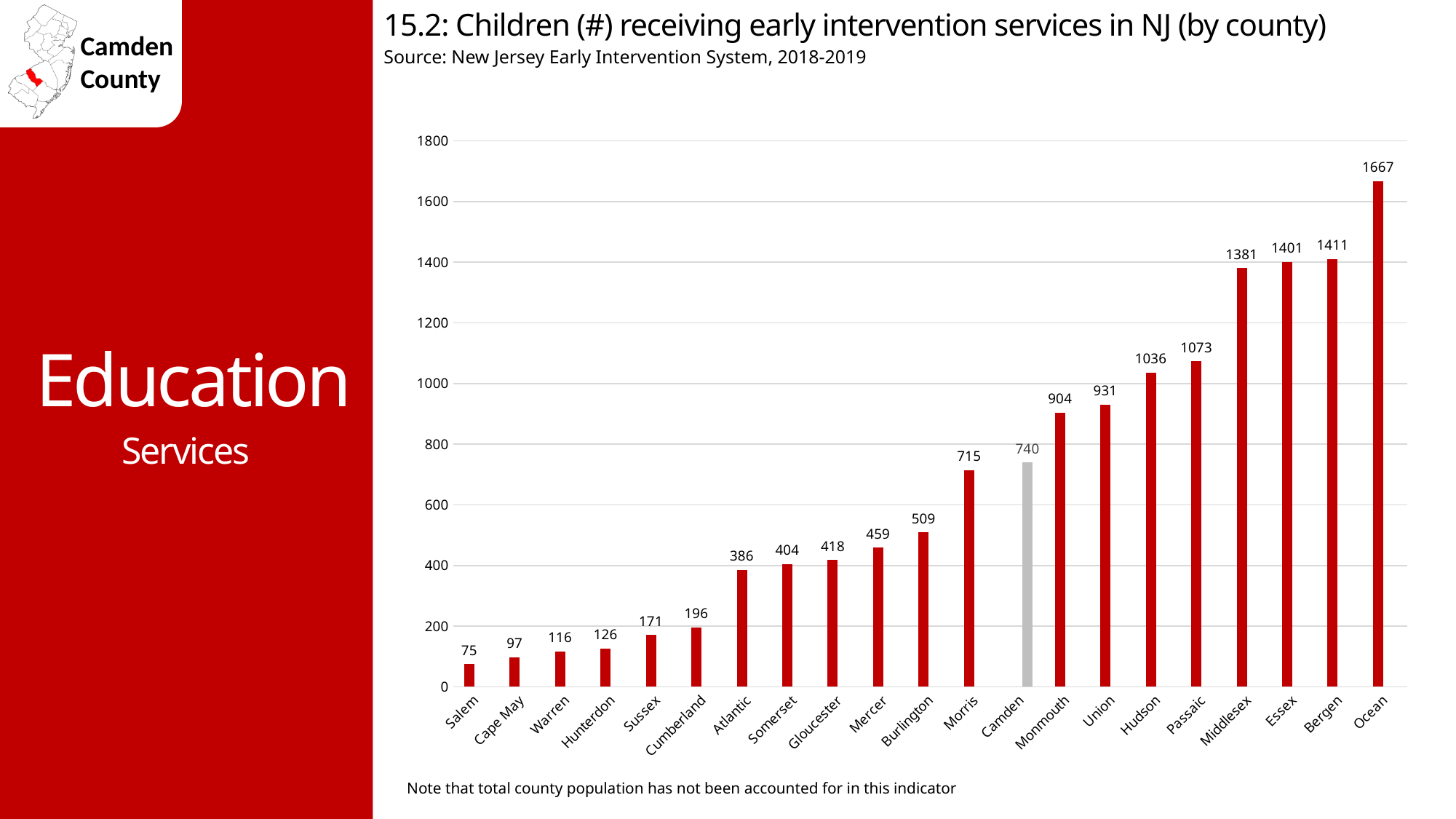
What is the difference between the values for Bergen and Essex? 10 How many children received early intervention services in Camden County? 740 What is the value shown for Gloucester County? 418 Which county has the highest number of children receiving early intervention services? Ocean What type of chart is shown on the slide? Bar chart What is the difference between the values for Ocean and Camden? 927 Which county has the lowest number of children receiving early intervention services? Salem How many counties are shown on the chart? 21 Which county's bar is coloured grey instead of red? Camden Which county has a larger value, Morris or Monmouth? Monmouth Is the value for Hudson greater or less than 1000? greater What is the value shown for Ocean County? 1667